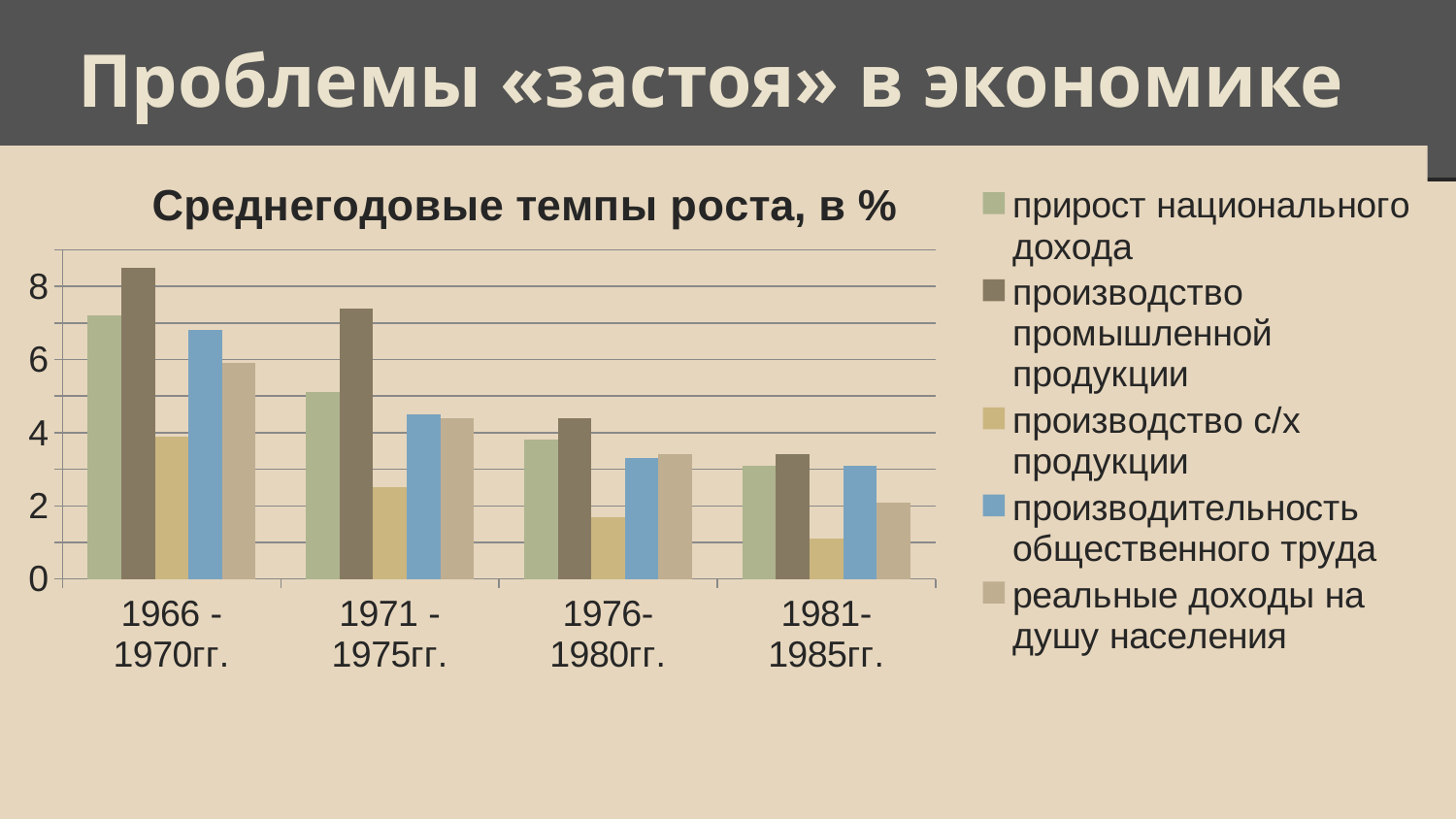
How many series does the legend of the chart list? 5 What kind of chart is shown on the slide? bar chart In 1966 - 1970гг., which is larger: прирост национального дохода or производство с/х продукции? прирост национального дохода How many time periods are shown on the x axis of the chart? 4 In which period is the value for производство с/х продукции the lowest? 1981-1985гг. In 1971 - 1975гг., which is larger: производство промышленной продукции or прирост национального дохода? производство промышленной продукции Does the value for прирост национального дохода rise or fall from 1966 - 1970гг. to 1981-1985гг.? fall In which period is the value for производство промышленной продукции the highest? 1966 - 1970гг. What is the title of the chart? Среднегодовые темпы роста, в % Is the value for производство с/х продукции in 1981-1985гг. greater or less than 2? less Is the value for производительность общественного труда in 1966 - 1970гг. greater or less than 6? greater Is the value for производство промышленной продукции in 1966 - 1970гг. greater or less than 8? greater